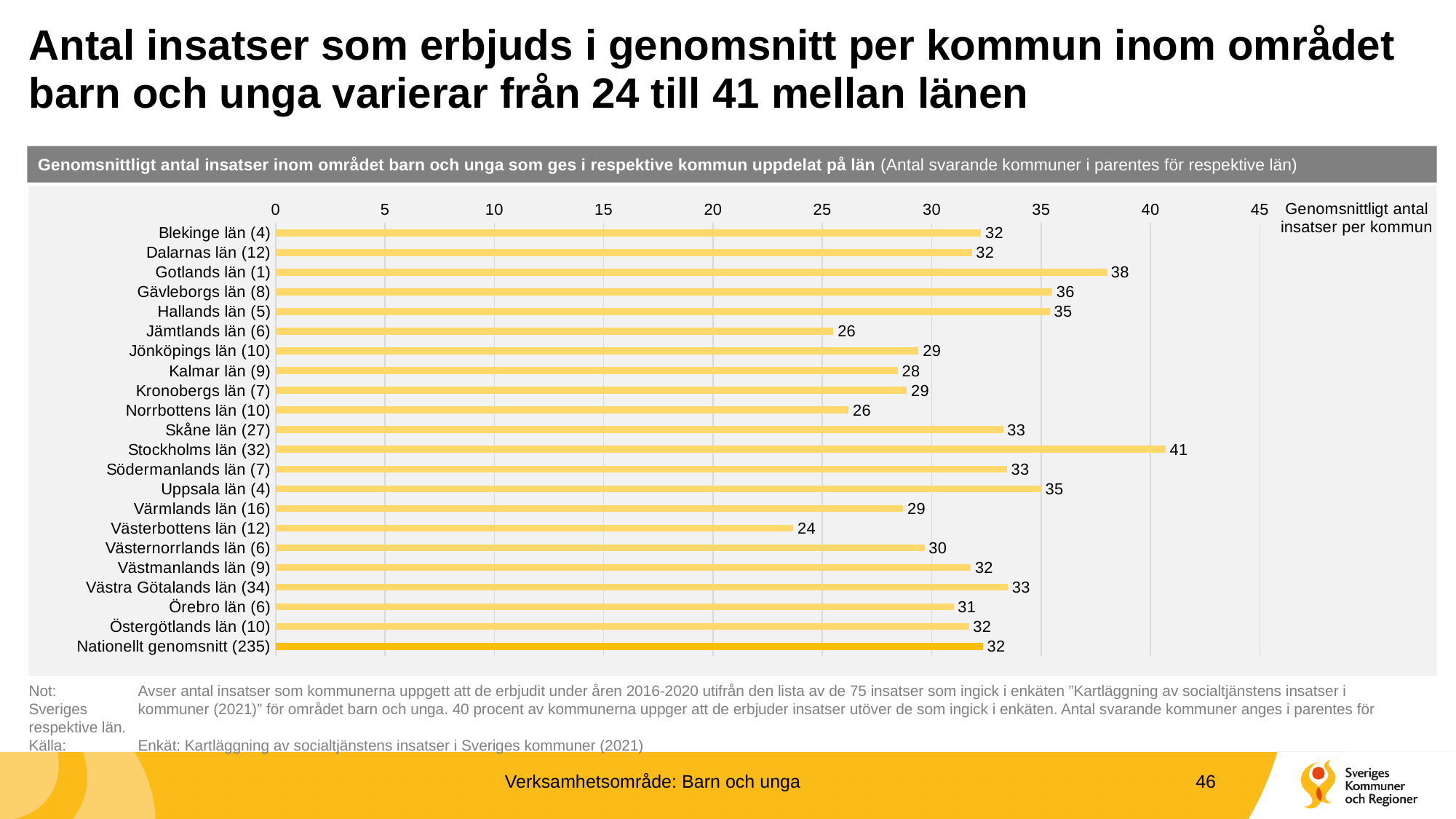
Which category has the lowest value? Västerbottens län (12) What kind of chart is shown on the slide? bar chart What is the difference between the values for Stockholms län (32) and Västerbottens län (12)? 17 How many categories are shown on the chart? 22 Which category has the highest value? Stockholms län (32) What is the value for Nationellt genomsnitt (235)? 32 What is the value for Stockholms län (32)? 41 What is the value for Västerbottens län (12)? 24 What is the value for Gävleborgs län (8)? 36 Is the value for Jämtlands län (6) greater or less than 30? less What is the legend entry shown on the chart? Genomsnittligt antal insatser per kommun Which is larger, the value for Gotlands län (1) or the value for Hallands län (5)? Gotlands län (1)